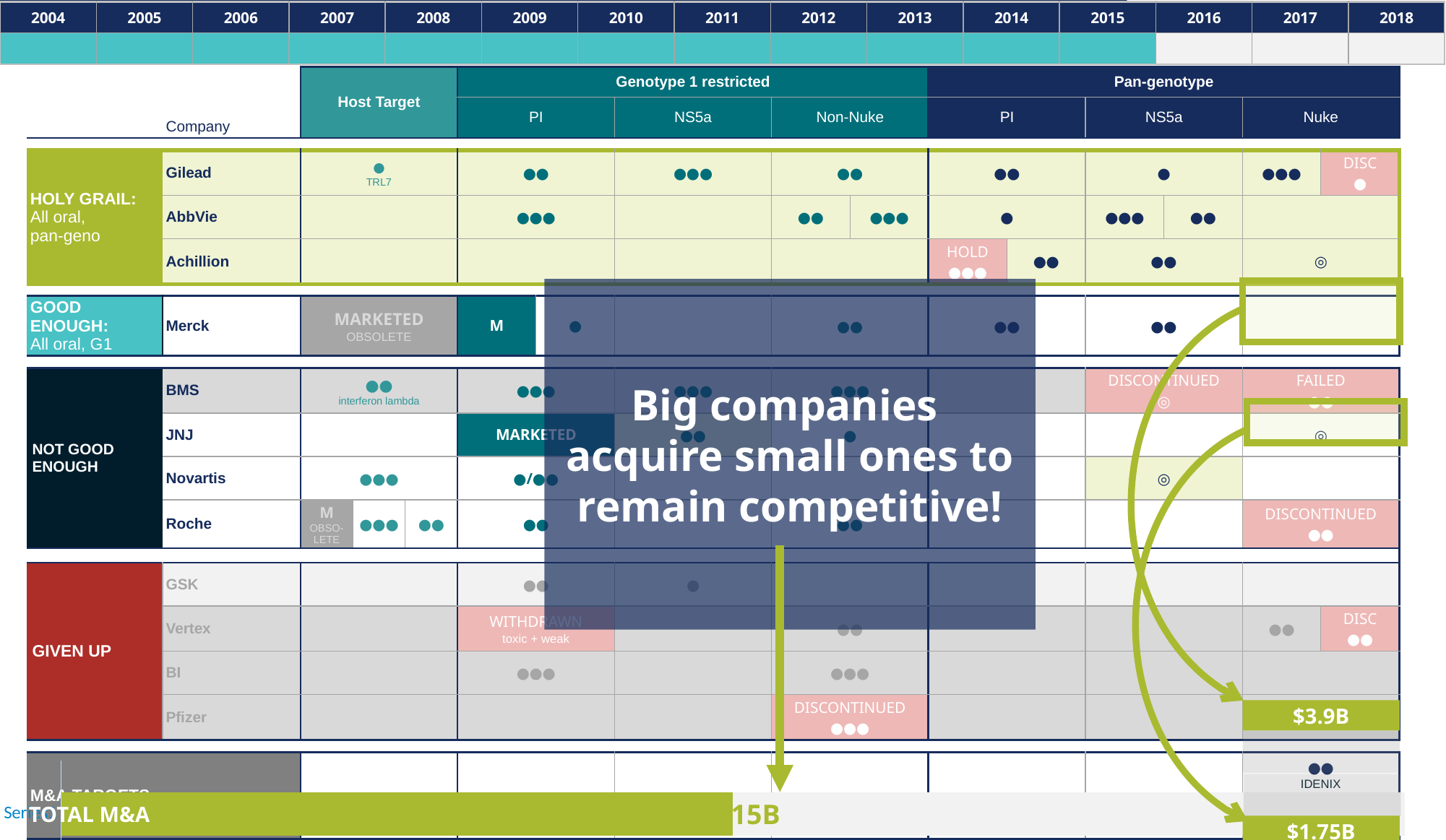
What is the first year shown on the timeline across the top of the slide? 2004 What M&A value is printed in the green box at the bottom right corner of the slide? $1.75B What is the difference between the $3.9B and $1.75B M&A values shown in the Nuke column? $2.15B Through which year is the teal bar under the timeline filled? 2015 How many years are listed on the timeline across the top of the slide? 15 What are the two top-level column groups to the right of Host Target? Genotype 1 restricted and Pan-genotype What M&A value is printed in the green box directly above the IDENIX entry in the Pan-genotype Nuke column? $3.9B How many companies are listed in the Company column of the table? 12 Which of the two M&A deal values shown in the Nuke column is larger, $3.9B or $1.75B? $3.9B What message is written in the large overlay box in the centre of the slide? Big companies acquire small ones to remain competitive! What is the last year shown on the timeline across the top of the slide? 2018 What value is printed at the end of the TOTAL M&A bar at the bottom of the slide? 15B